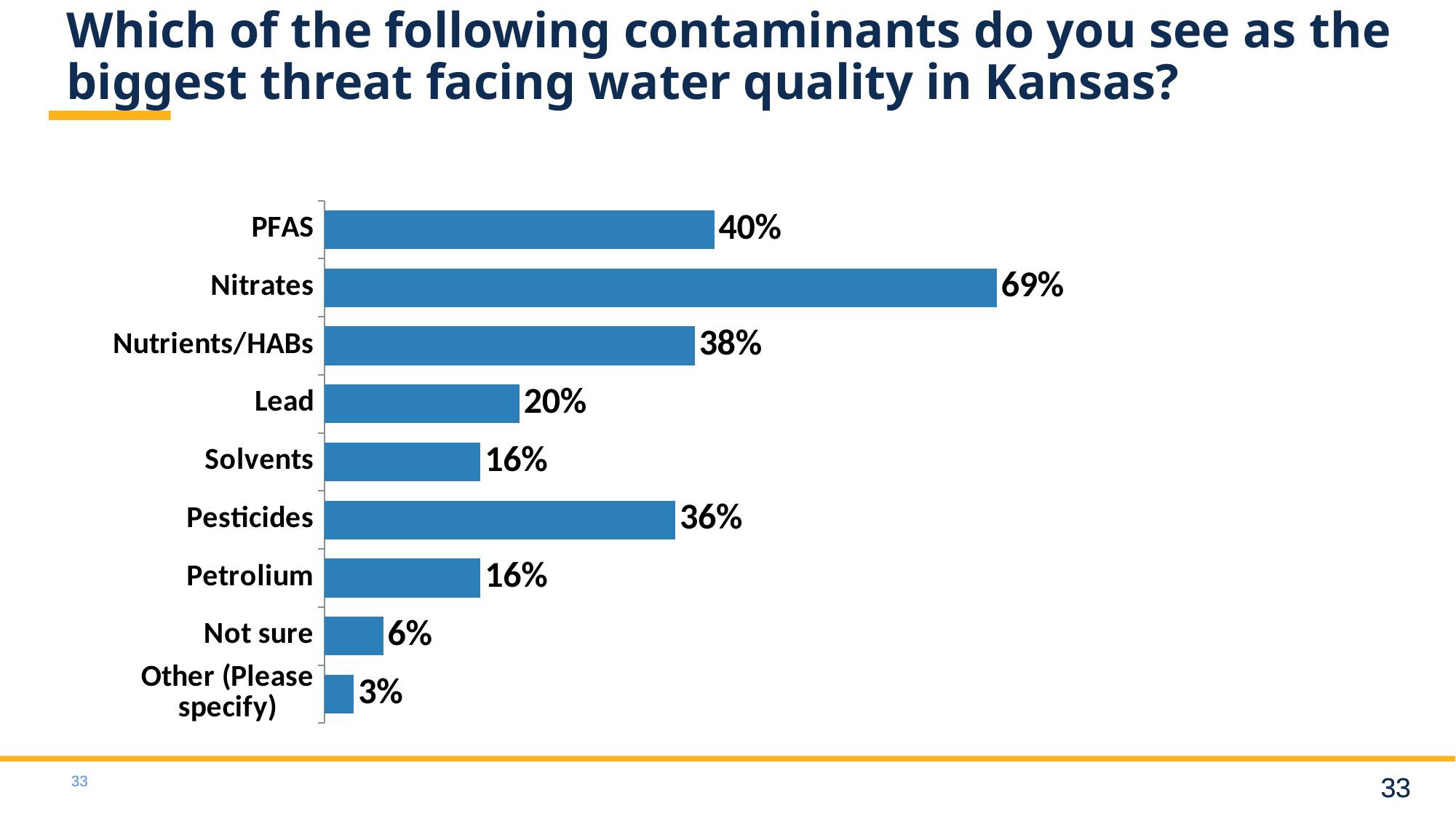
What is the difference between the values for Pesticides and Lead? 16% Which category has the lowest percentage? Other (Please specify) What is the difference between the values for Nitrates and PFAS? 29% Which contaminant has the highest percentage? Nitrates What type of chart is shown on the slide? Bar chart What is the value shown for PFAS? 40% Which two categories share the same value of 16%? Solvents and Petrolium How many categories are shown in the chart? 9 What percentage of respondents selected Nitrates as the biggest threat? 69% What percentage is shown for Lead? 20% Which is larger, the value for Nutrients/HABs or the value for Pesticides? Nutrients/HABs What is the value for Not sure? 6%